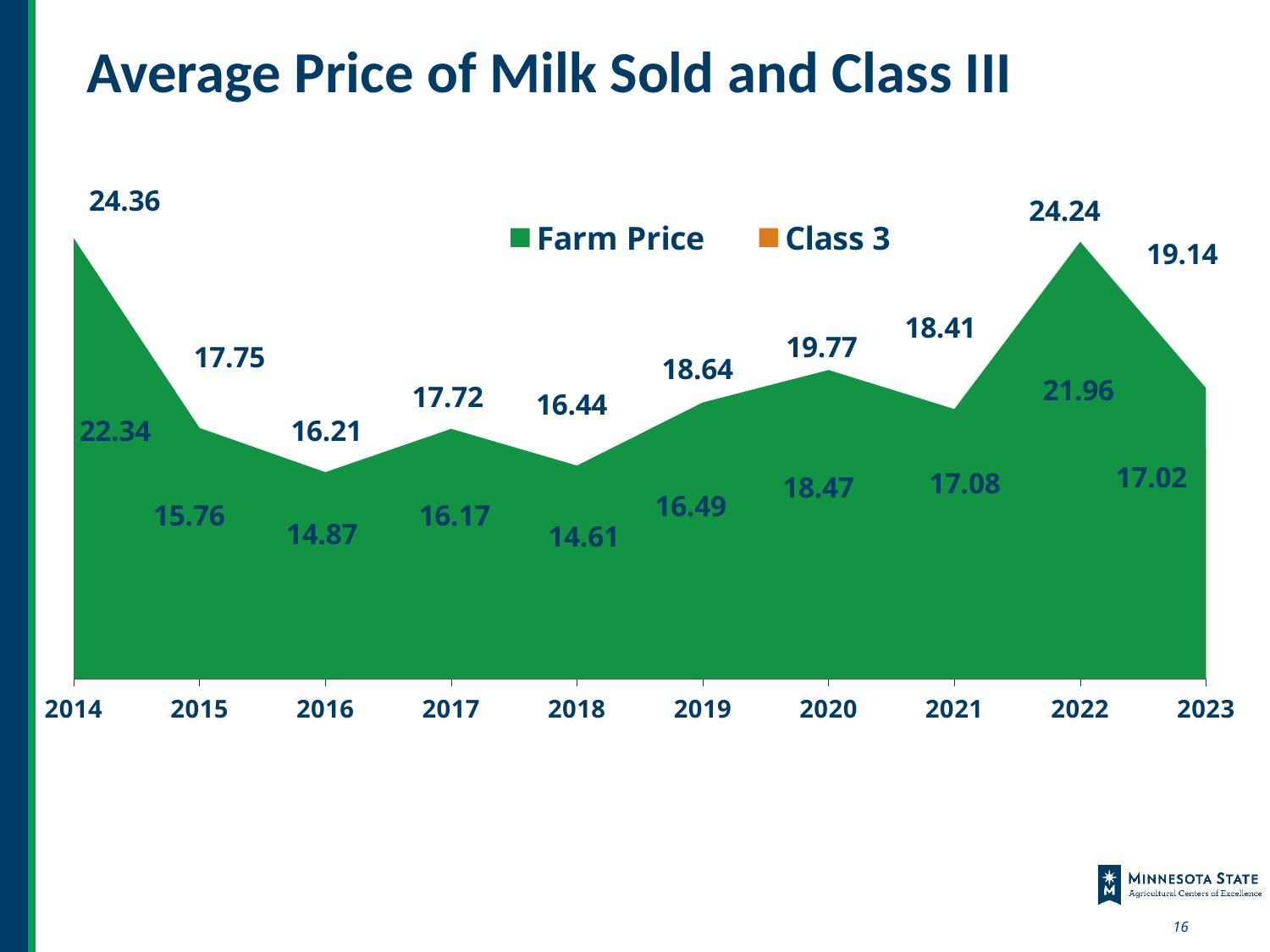
What kind of chart is shown on the slide? Area chart Which year has the lowest Class 3 value? 2018 What is the Farm Price value for 2020? 19.77 How many years are shown on the x axis? 10 What is the Class 3 value for 2018? 14.61 What is the Class 3 value for 2022? 21.96 Which is larger, the Farm Price in 2019 or the Farm Price in 2021? 2019 What is the difference between the Farm Price and Class 3 values in 2023? 2.12 How many series does the legend list? 2 Does the Farm Price rise or fall from 2022 to 2023? Fall Which year has the highest Farm Price? 2014 What is the Farm Price value for 2014? 24.36